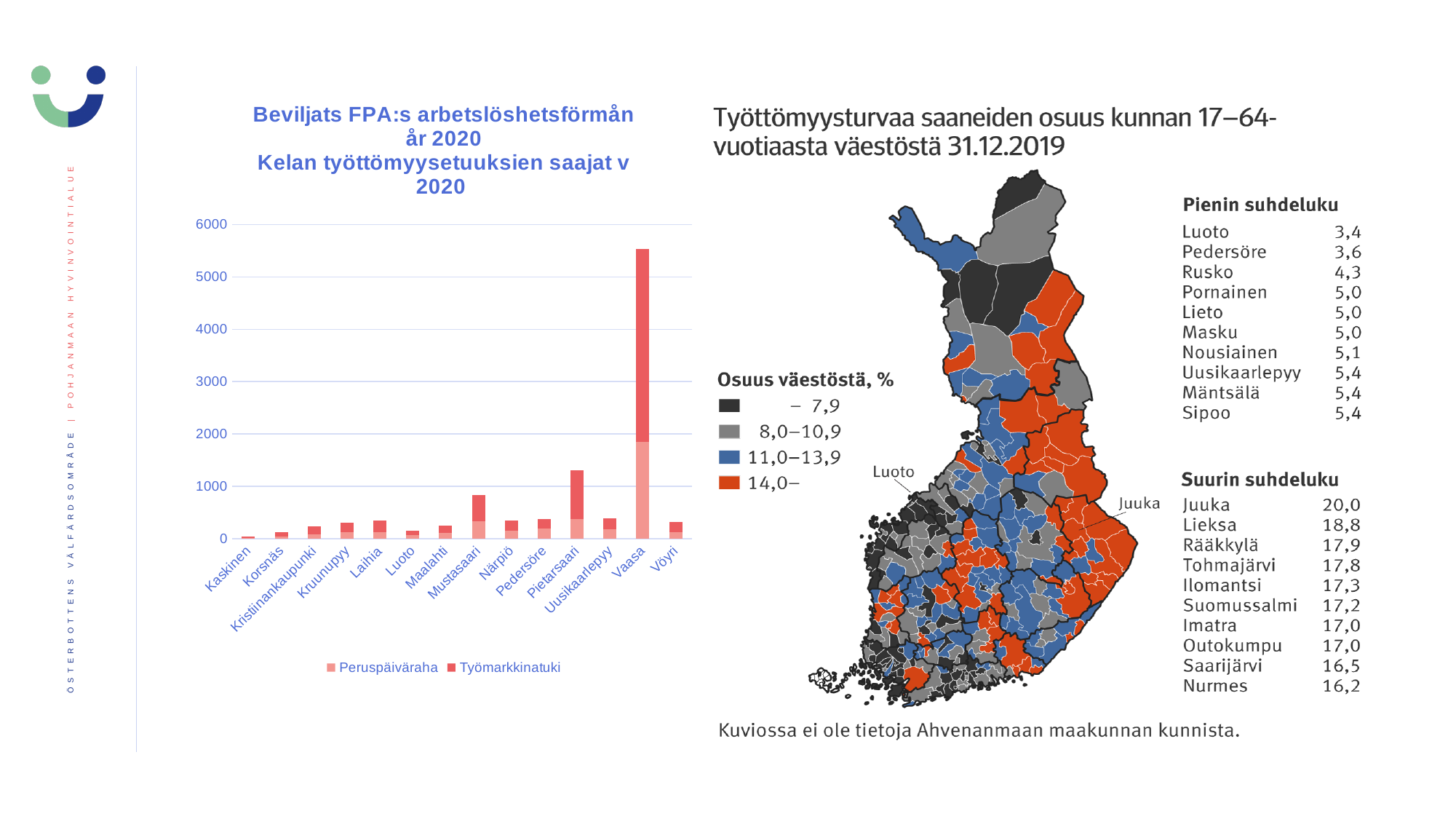
In the bar chart, which has a taller bar, Vaasa or Pietarsaari? Vaasa What are the two series named in the legend of the bar chart? Peruspäiväraha and Työmarkkinatuki How many municipalities (categories) are shown on the x axis of the bar chart? 14 In the bar chart, which has a taller bar, Pietarsaari or Mustasaari? Pietarsaari How many series does the legend of the bar chart list? 2 What is the highest value shown on the y axis of the bar chart? 6000 Which municipality has the shortest bar in the bar chart? Kaskinen In the bar chart, is the total bar for Vaasa greater or less than 5000? greater In the bar chart, is the total bar for Pietarsaari greater or less than 1000? greater Which municipality has the tallest bar in the bar chart? Vaasa What kind of chart is shown on the left of the slide? Stacked bar chart In the bar chart, is the total bar for Mustasaari greater or less than 1000? less